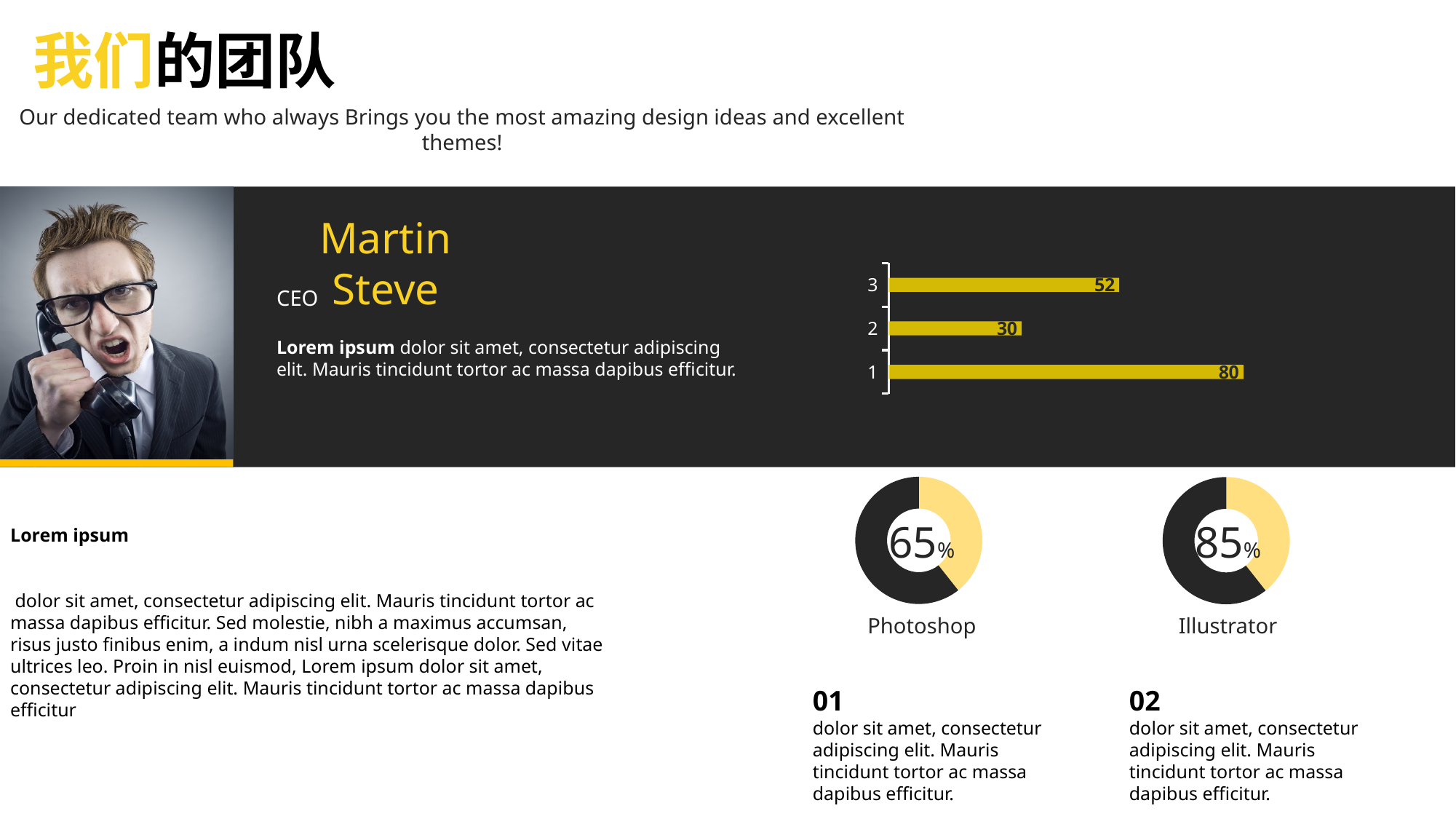
What percentage is shown in the Illustrator donut chart? 85% In the bar chart on the dark panel, what is the difference between the values for category 1 and category 2? 50 In the bar chart on the dark panel, which category has the lowest value? 2 Which of the two donut charts shows the larger percentage, Photoshop or Illustrator? Illustrator How many bars are in the bar chart on the dark panel? 3 What percentage is shown in the Photoshop donut chart? 65% In the bar chart on the dark panel, what is the value for category 3? 52 In the bar chart on the dark panel, what is the value for category 1? 80 In the bar chart on the dark panel, what is the value for category 2? 30 In the bar chart on the dark panel, which category has the highest value? 1 What kind of chart is shown on the dark panel next to the CEO description? bar chart In the bar chart on the dark panel, which is larger, the value for category 3 or category 2? category 3